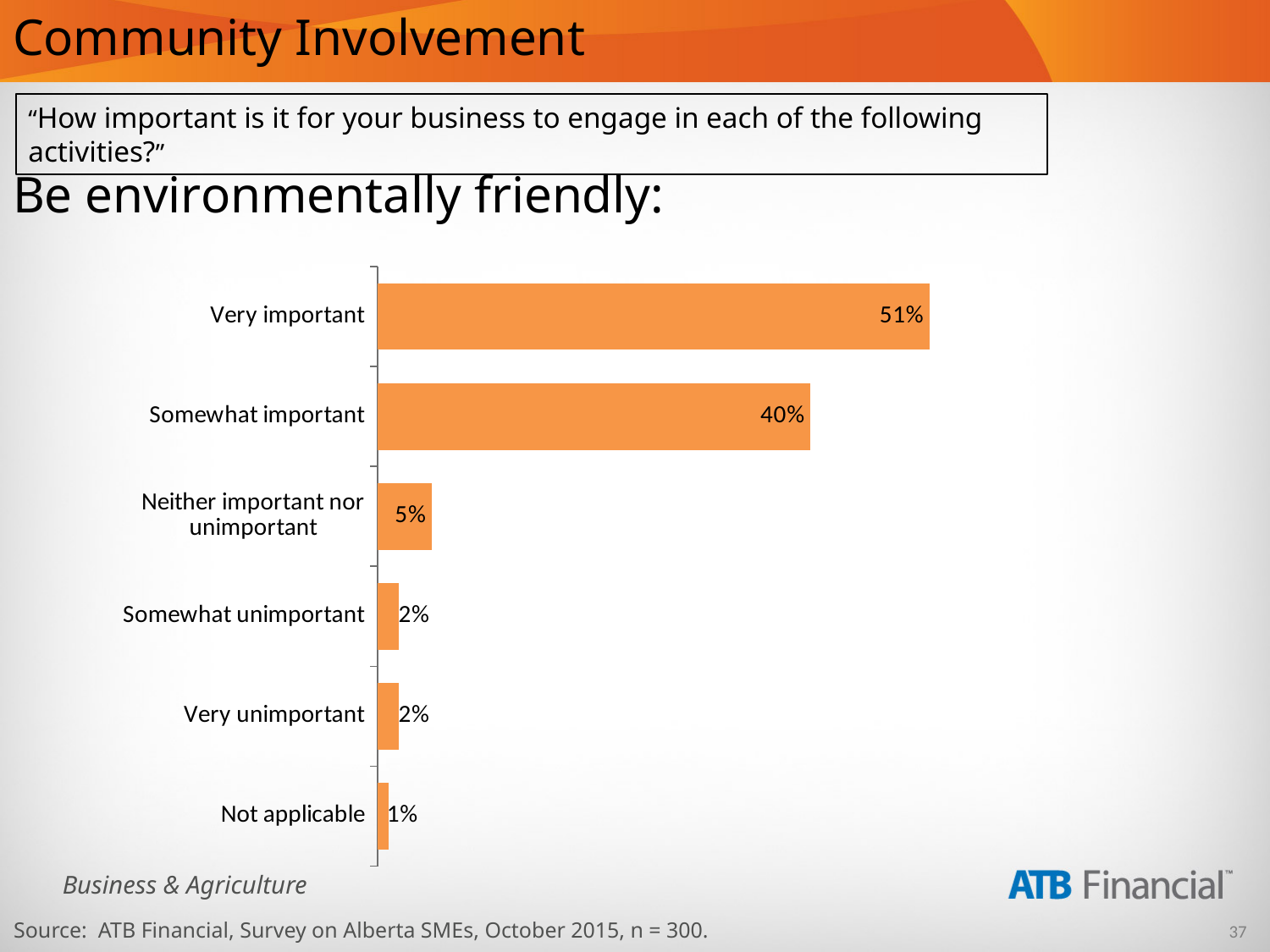
What activity does the chart on this slide refer to? Be environmentally friendly Which is larger, Neither important nor unimportant or Somewhat unimportant? Neither important nor unimportant What is the value for Somewhat important? 40% What percentage of respondents said being environmentally friendly is very important? 51% How many categories are shown in the chart? 6 Which category has the highest value? Very important What is the value for Neither important nor unimportant? 5% What is the combined value of Very important and Somewhat important? 91% Which category has the lowest value? Not applicable What kind of chart is shown on the slide? Bar chart What is the difference between Very important and Somewhat important? 11% What is the value for Not applicable? 1%